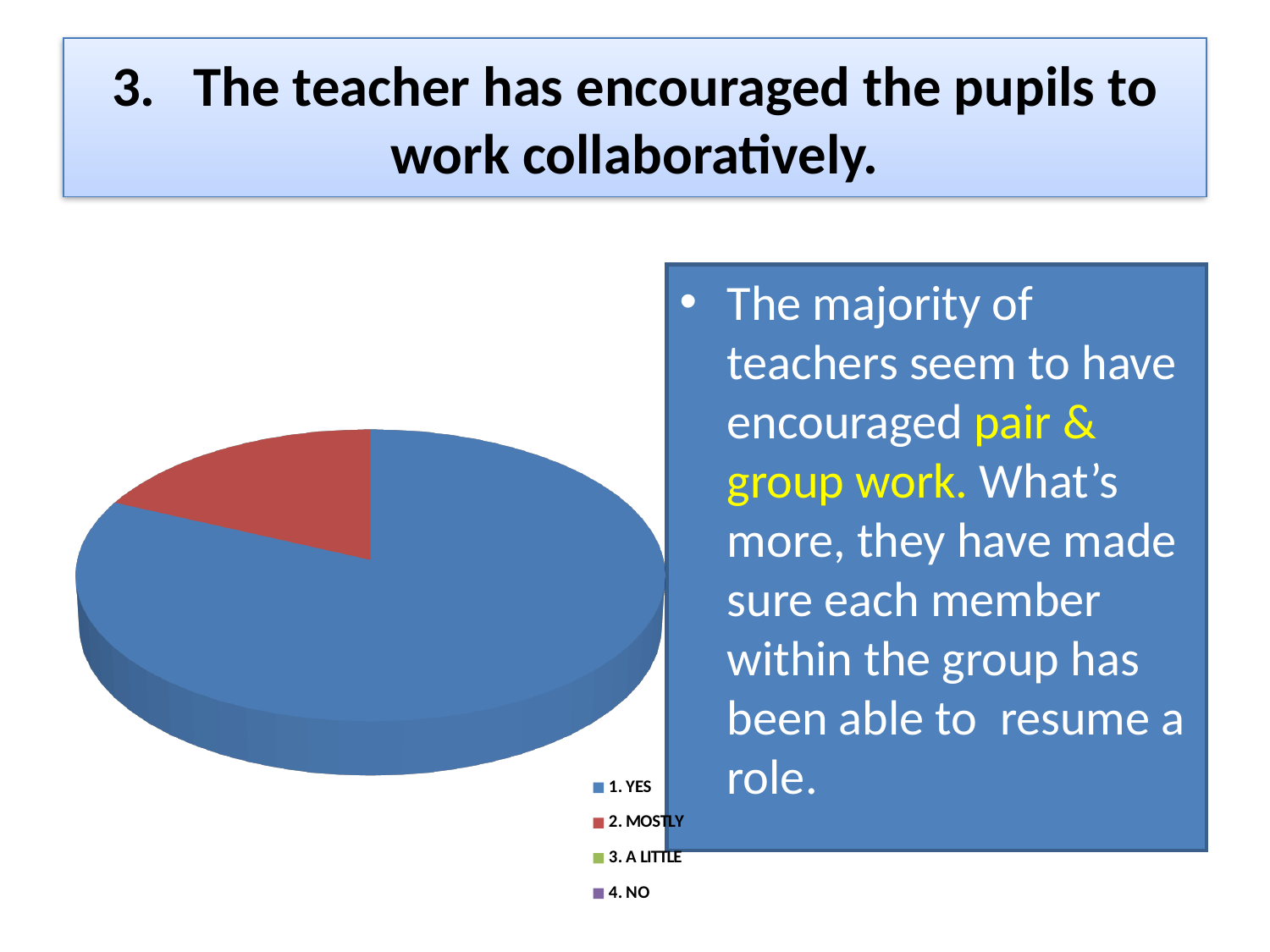
Which legend entry is listed last? 4. NO What colour represents 2. MOSTLY in the pie chart? red Which category has the largest slice of the pie? 1. YES Which is larger, the slice for 1. YES or the slice for 2. MOSTLY? 1. YES What colour represents 1. YES in the pie chart? blue How many entries does the chart legend list? 4 How many slices are visibly drawn in the pie? 2 What kind of chart is shown on the slide? pie chart